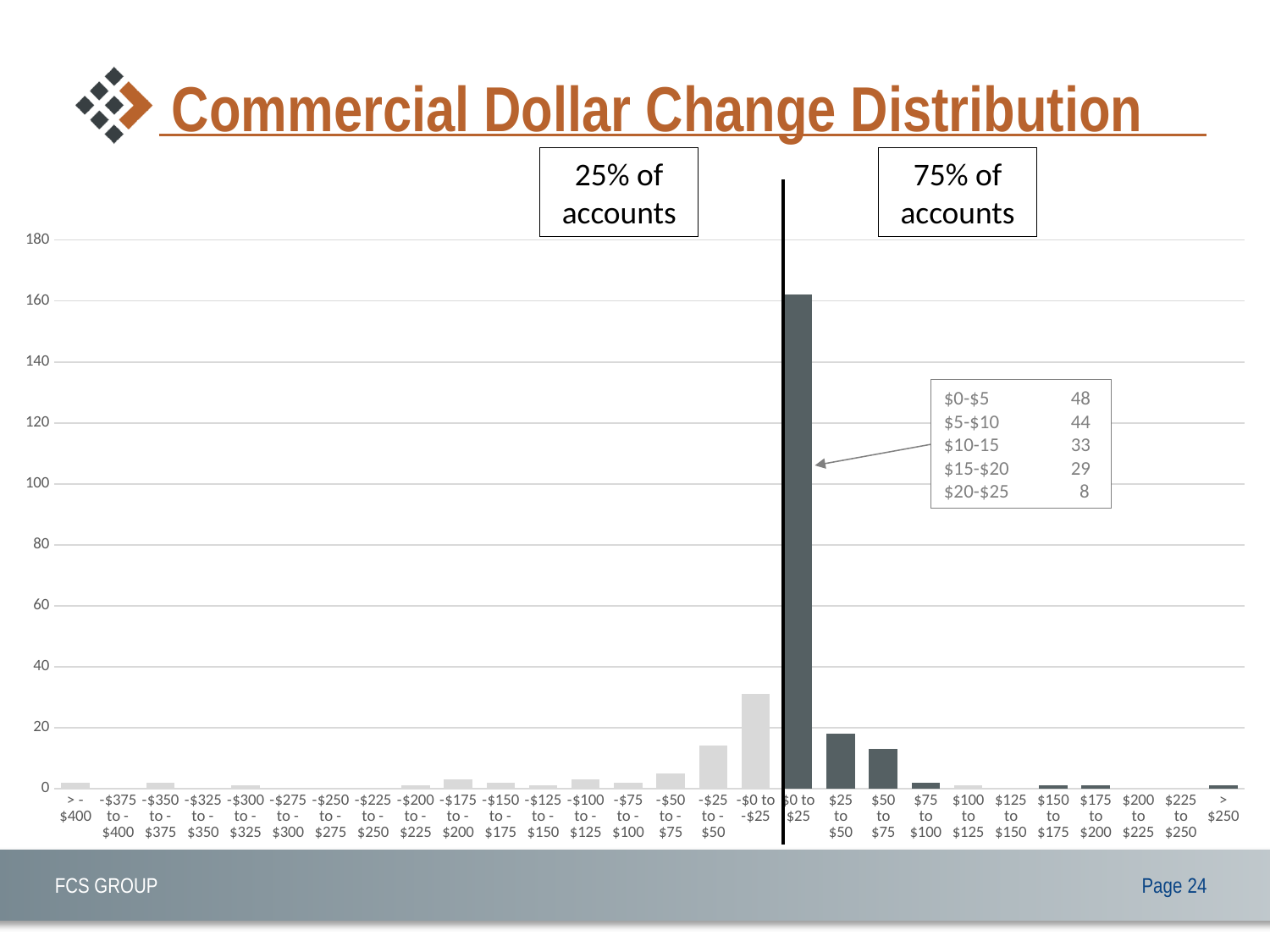
Is the value for the -$0 to -$25 bar greater or less than 20? greater Which category has the tallest bar in the chart? $0 to $25 Is the value for the $25 to $50 bar greater or less than 20? less According to the callout box, how many accounts fall in the $20-$25 range? 8 What is the title of the chart? Commercial Dollar Change Distribution According to the callout box, how many accounts fall in the $0-$5 range? 48 Which bar is taller, $25 to $50 or $50 to $75? $25 to $50 Which bar is taller, -$0 to -$25 or $25 to $50? -$0 to -$25 Is the value for the $0 to $25 bar greater or less than 140? greater How many categories are shown along the x axis of the chart? 28 What type of chart is shown on the slide? Bar chart What is the difference between the $0-$5 and $5-$10 values in the callout box? 4